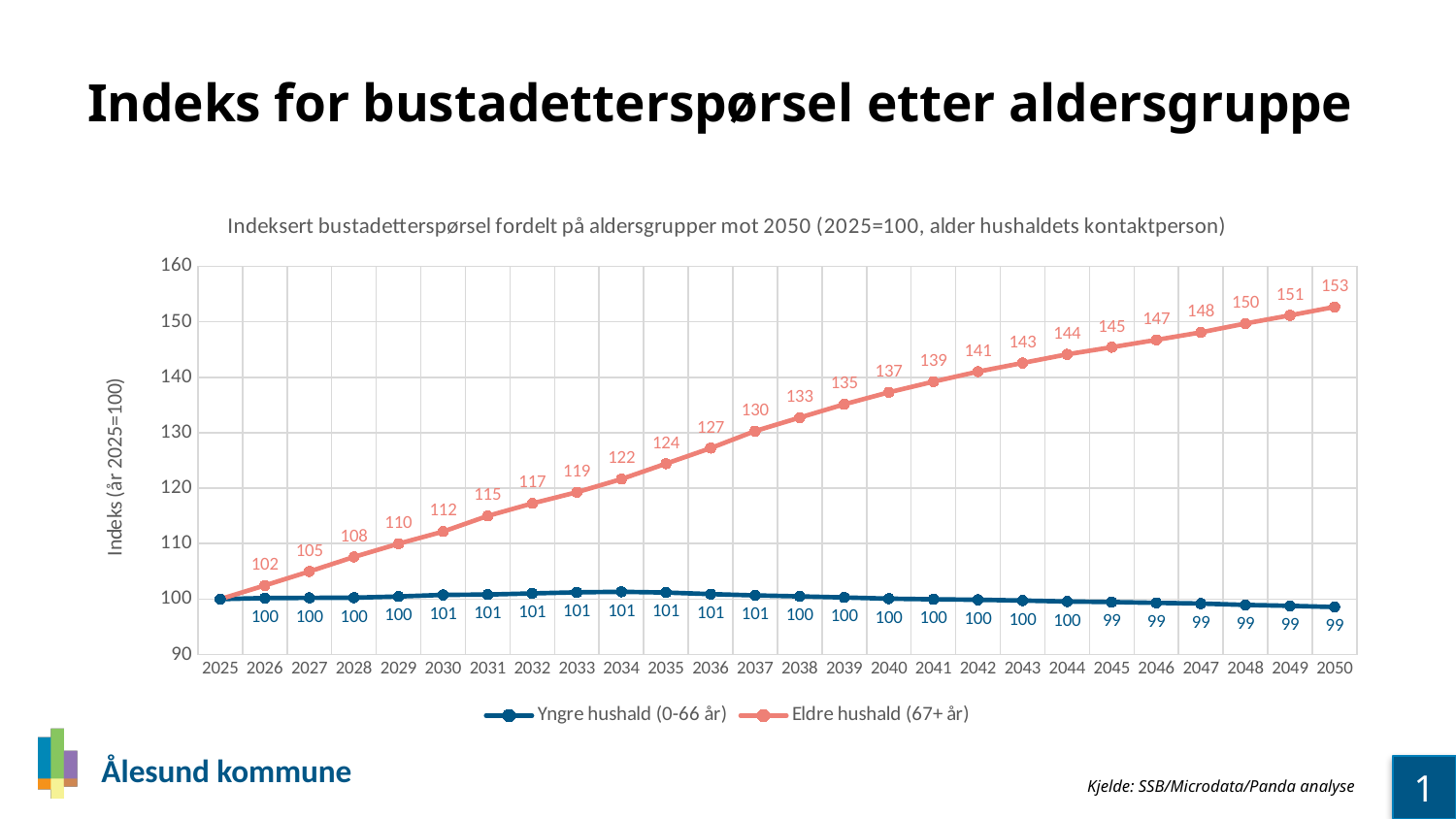
In which year does the Eldre hushald (67+ år) series reach its highest value? 2050 What is the value for Yngre hushald (0-66 år) in 2050? 99 By how much does the Eldre hushald (67+ år) value increase from 2030 to 2040? 25 Which series has the higher value in 2045, Eldre hushald (67+ år) or Yngre hushald (0-66 år)? Eldre hushald (67+ år) What kind of chart is shown on the slide? Line chart What is the value for Eldre hushald (67+ år) in 2050? 153 Is the value for Eldre hushald (67+ år) in 2025 greater or less than 110? less What is the value for Eldre hushald (67+ år) in 2037? 130 What is the value for Yngre hushald (0-66 år) in 2034? 101 How many series does the legend list? 2 What is the difference between the Eldre hushald (67+ år) and Yngre hushald (0-66 år) values in 2050? 54 Does the Eldre hushald (67+ år) series rise or fall from 2025 to 2050? Rise